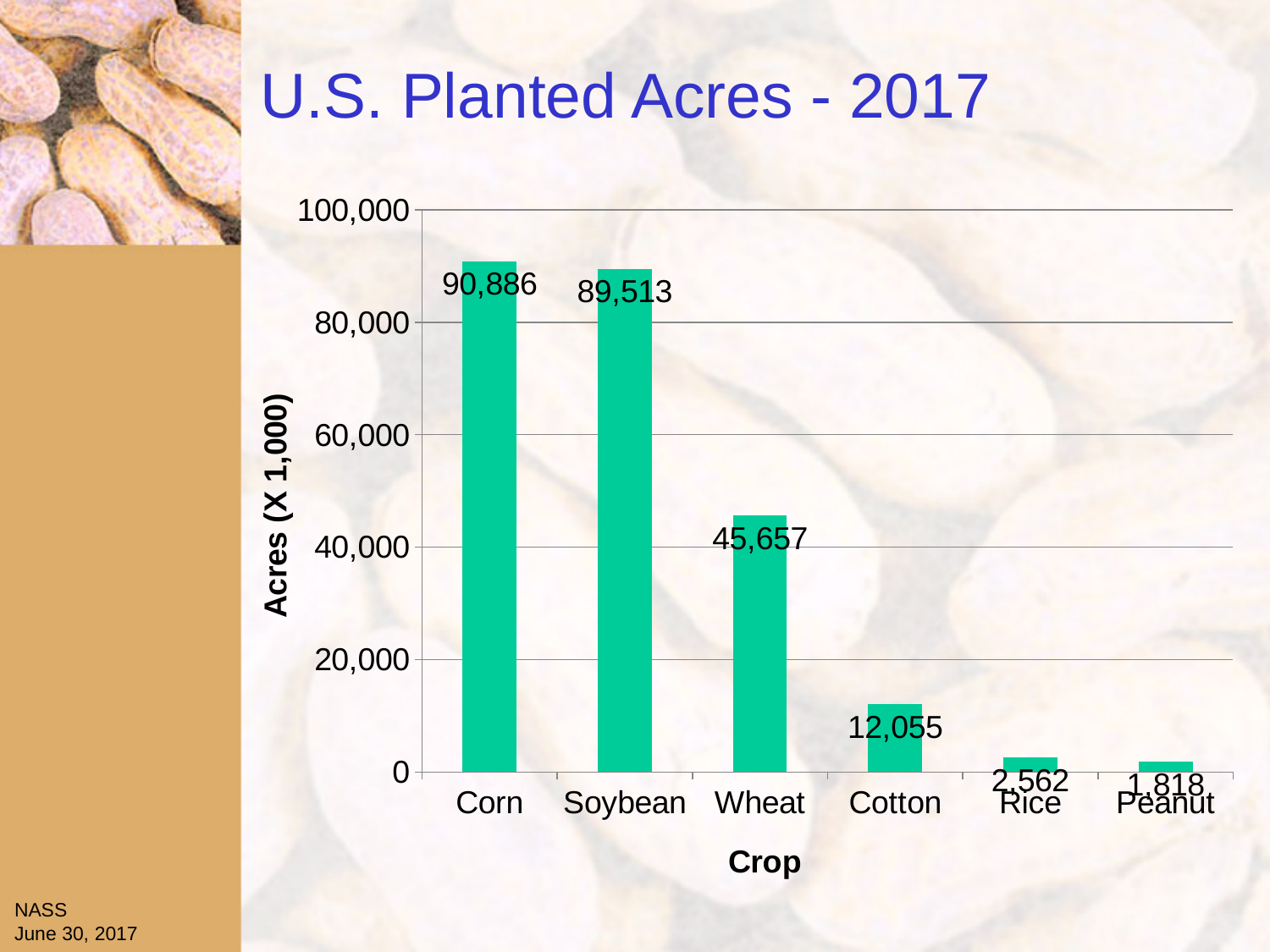
What is the value for Corn? 90,886 What type of chart is shown on the slide? bar chart What is the value for Peanut? 1,818 What is the title of the chart? U.S. Planted Acres - 2017 Which is larger, the value for Rice or the value for Peanut? Rice Which crop has the lowest planted acres? Peanut What is the difference between the values for Wheat and Cotton? 33,602 Which crop has the highest planted acres? Corn What is the difference between the values for Corn and Soybean? 1,373 How many crops are shown on the chart? 6 What is the value for Wheat? 45,657 Do the values rise or fall from left to right along the x axis? fall